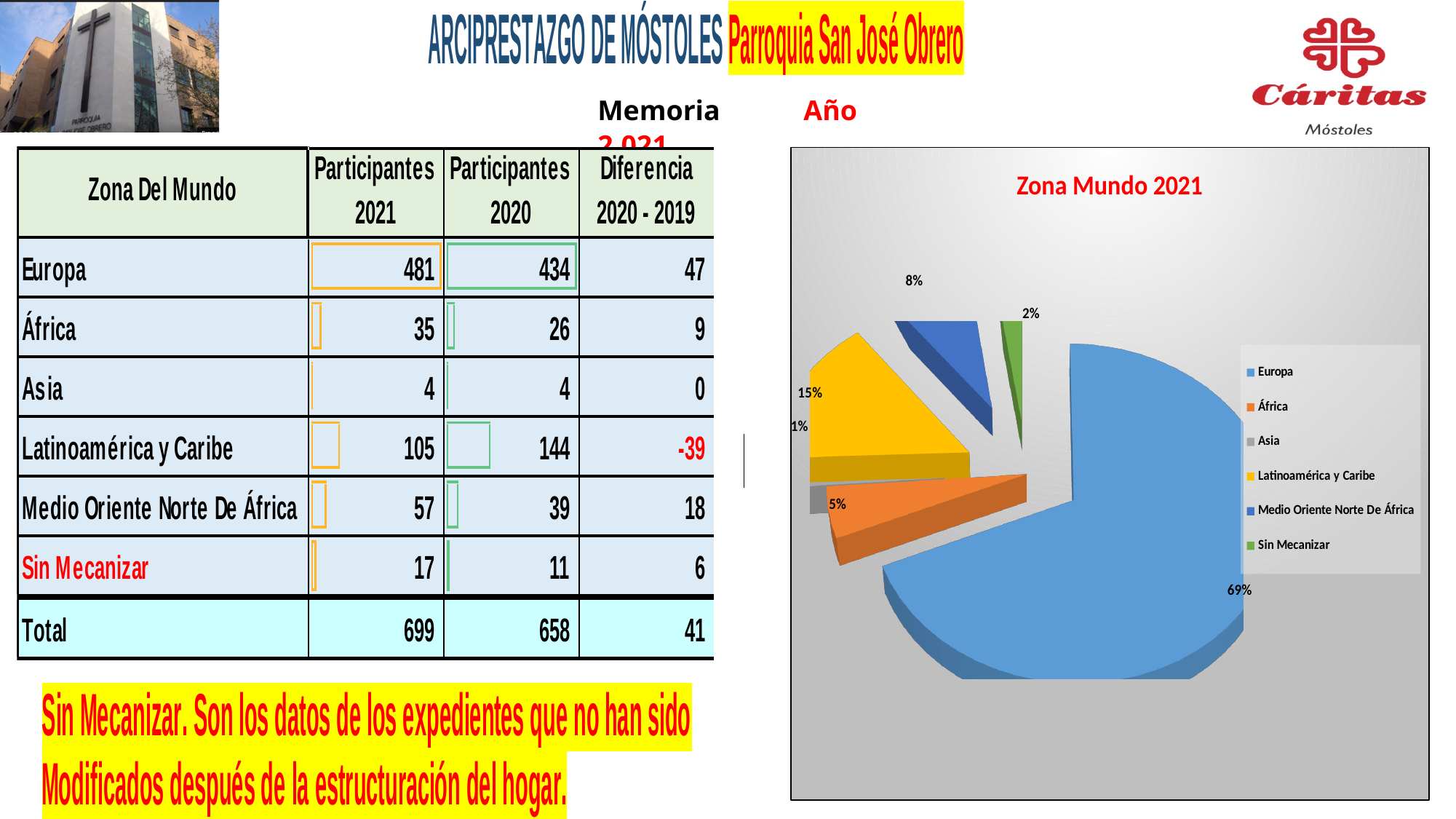
In the "Zona Mundo 2021" pie chart, what share does Latinoamérica y Caribe have? 15% What kind of chart is shown under the title "Zona Mundo 2021"? pie chart In the "Zona Mundo 2021" pie chart, what share does África have? 5% How many categories does the legend of the "Zona Mundo 2021" pie chart list? 6 In the "Zona Mundo 2021" pie chart, which slice is larger: Latinoamérica y Caribe or Medio Oriente Norte De África? Latinoamérica y Caribe Which category has the largest slice in the "Zona Mundo 2021" pie chart? Europa What colour is the Europa slice in the "Zona Mundo 2021" pie chart? blue In the "Zona Mundo 2021" pie chart, what share does Medio Oriente Norte De África have? 8% Which category has the smallest slice in the "Zona Mundo 2021" pie chart? Asia In the "Zona Mundo 2021" pie chart, what is the difference in percentage points between the Europa slice and the Latinoamérica y Caribe slice? 54